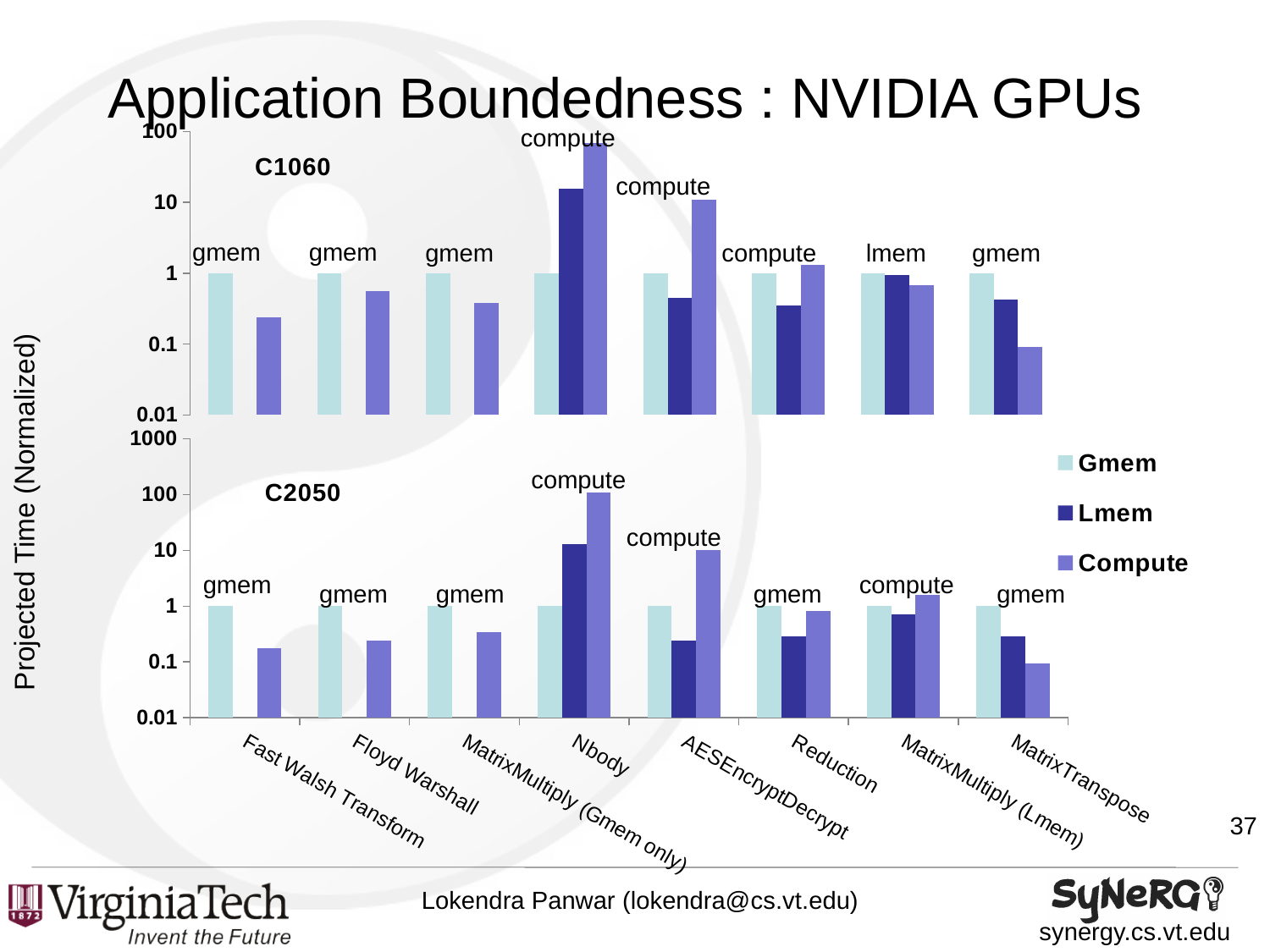
In the C1060 chart, is the Compute value for Fast Walsh Transform greater or less than 1? less In the C1060 chart, what annotation label is written above the MatrixMultiply (Lmem) bars? lmem In the C1060 chart, is the Compute value for Nbody greater or less than 10? greater In the C1060 chart, for Reduction, which is larger: the Lmem bar or the Compute bar? Compute In the C2050 chart, which application has the highest Compute bar? Nbody What kind of chart is the C1060 chart? bar chart In the C1060 chart, what is the Gmem value for Nbody? 1 In the C2050 chart, for MatrixMultiply (Lmem), which is larger: the Lmem bar or the Compute bar? Compute How many series does the legend list? 3 In the C2050 chart, is the Compute value for MatrixTranspose greater or less than 1? less In the C1060 chart, which application has the highest Compute bar? Nbody How many applications are shown along the x axis of the C2050 chart? 8